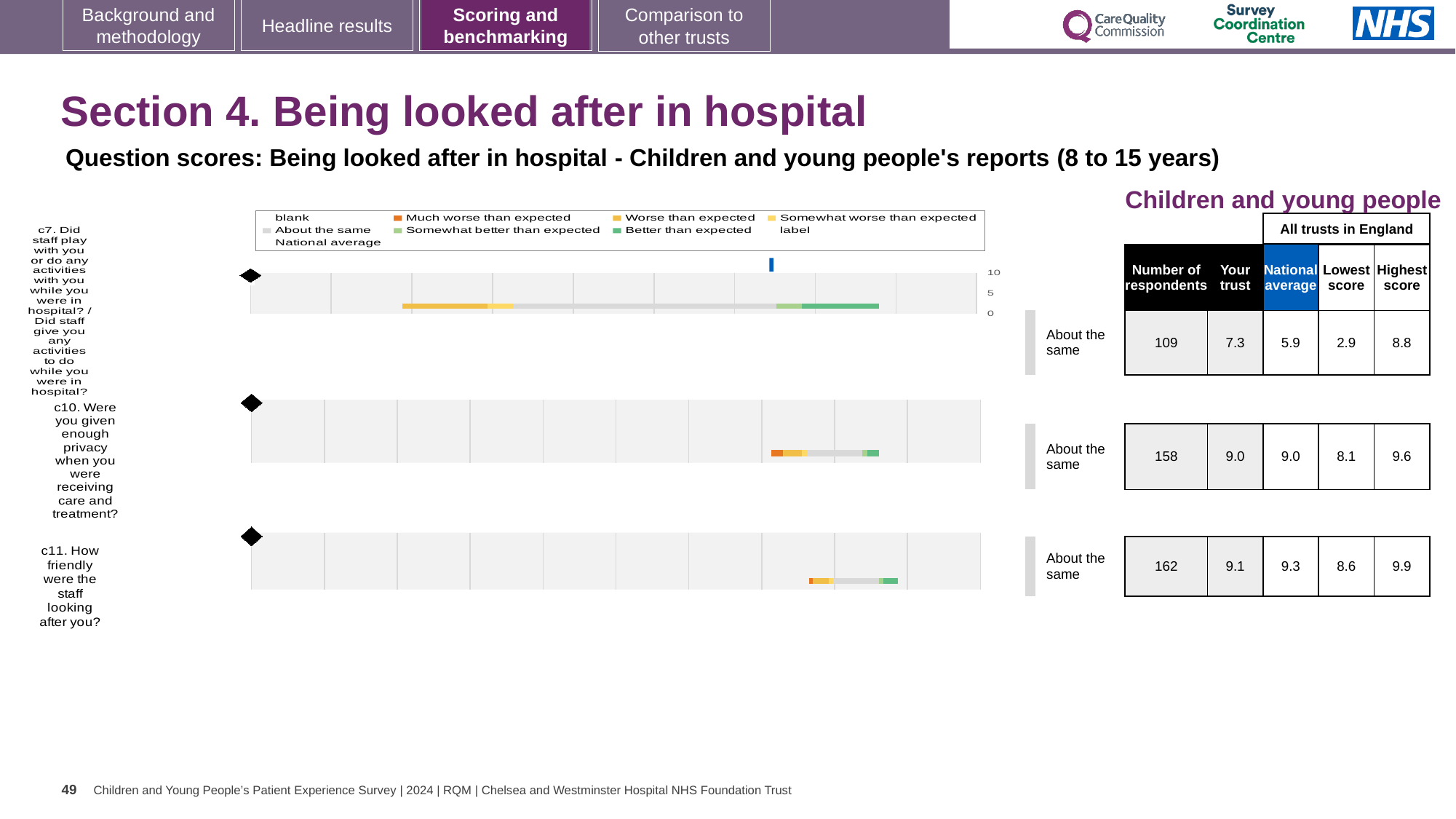
What is the difference between the highest score and the lowest score for question c7? 5.9 What is the national average score for question c10 (Were you given enough privacy when you were receiving care and treatment?)? 9.0 Which question has the lowest 'Your trust' score on this slide? c7. Did staff play with you or do any activities with you while you were in hospital? What is the highest score among all trusts in England for question c7? 8.8 What is the lowest score among all trusts in England for question c11? 8.6 Which question has the highest 'Your trust' score on this slide? c11. How friendly were the staff looking after you? How many questions are plotted on this slide? 3 What benchmark category is shown for question c10? About the same How many respondents answered question c11 (How friendly were the staff looking after you?)? 162 What kind of chart is used to show the question scores on this slide? Bar chart What is the 'Your trust' score for question c7 (Did staff play with you or do any activities with you while you were in hospital?)? 7.3 For question c11, which is larger: the 'Your trust' score or the national average? National average